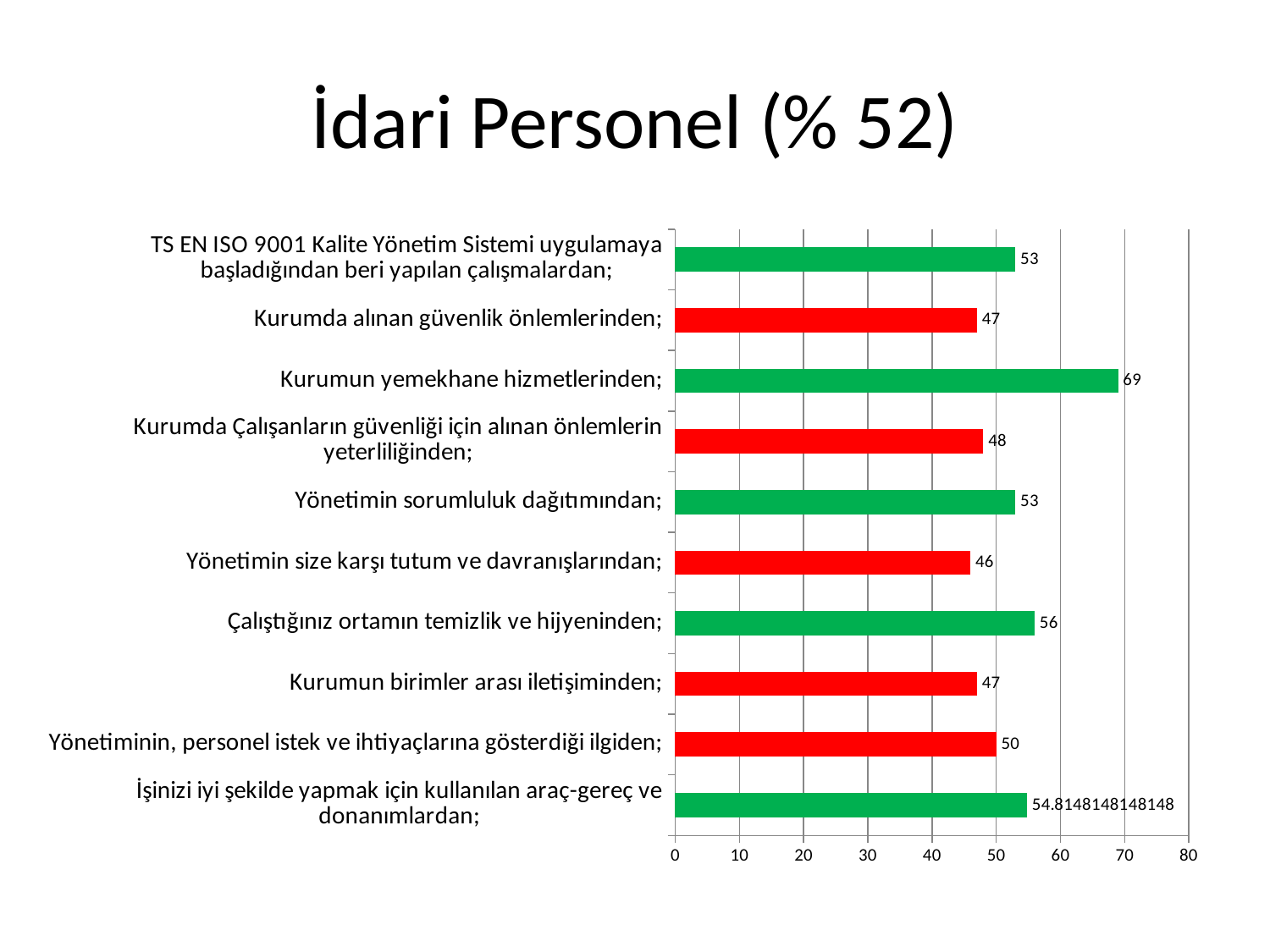
What is the value for "Çalıştığınız ortamın temizlik ve hijyeninden"? 56 How many categories are shown in the chart? 10 What kind of chart is shown on the slide? bar chart What is the difference between the values for "Kurumun yemekhane hizmetlerinden" and "Yönetimin size karşı tutum ve davranışlarından"? 23 What is the title of the slide? İdari Personel (% 52) Which is larger: the value for "Çalıştığınız ortamın temizlik ve hijyeninden" or the value for "Kurumun birimler arası iletişiminden"? Çalıştığınız ortamın temizlik ve hijyeninden What is the value for "Kurumun yemekhane hizmetlerinden"? 69 What is the value for "Yönetimin size karşı tutum ve davranışlarından"? 46 Is the value for "Kurumun yemekhane hizmetlerinden" greater or less than 60? greater Which category has the lowest value? Yönetimin size karşı tutum ve davranışlarından What is the value for "İşinizi iyi şekilde yapmak için kullanılan araç-gereç ve donanımlardan"? 54.8148148148148 Which category has the highest value? Kurumun yemekhane hizmetlerinden